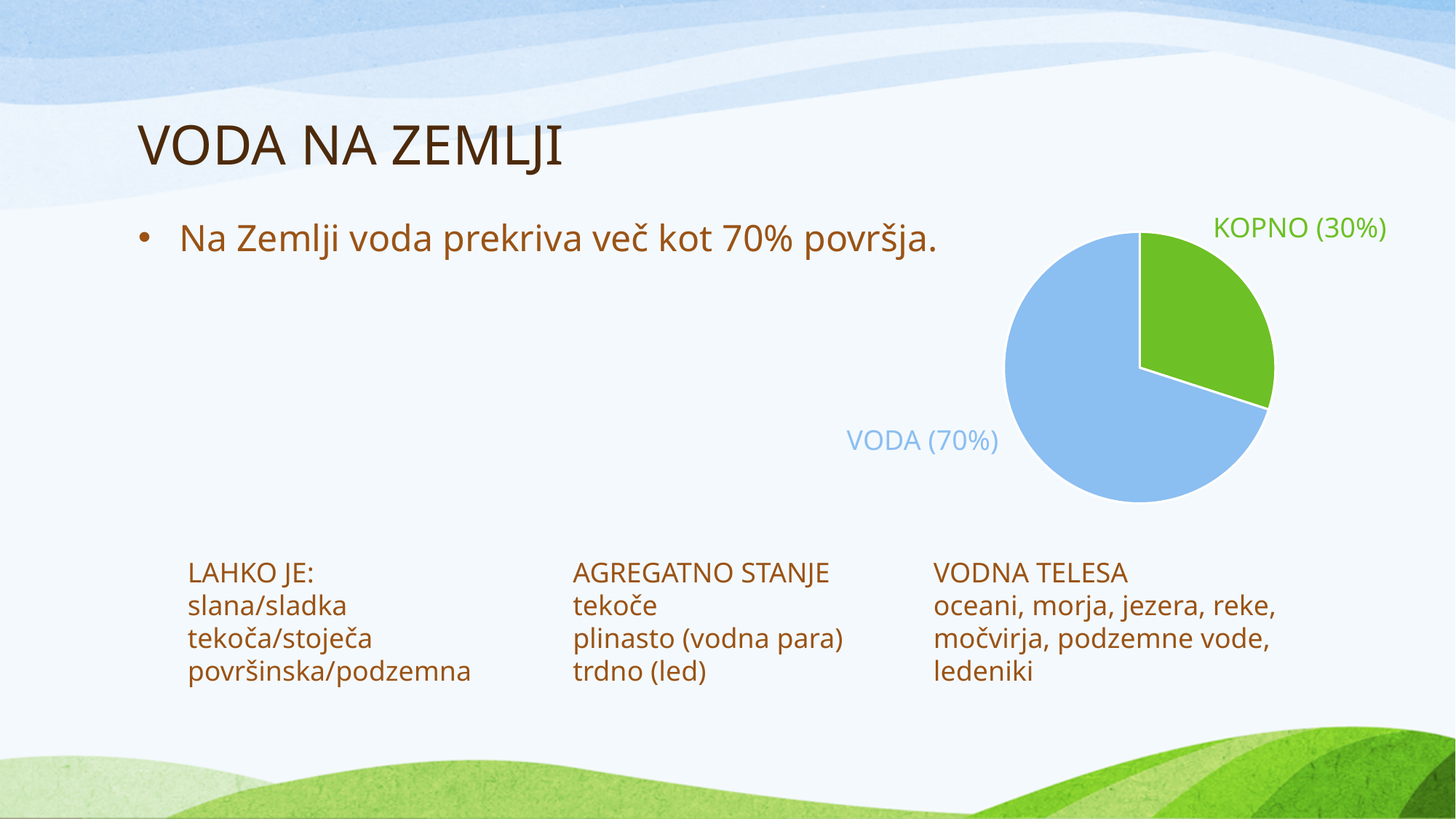
What colour is the VODA slice in the pie chart? blue Which slice of the pie chart is the largest? VODA What share of the pie does VODA represent? 70% Which slice of the pie chart is the smallest? KOPNO What colour is the KOPNO slice in the pie chart? green How many slices does the pie chart have? 2 What share of the pie does KOPNO represent? 30% What kind of chart is shown on the slide? pie chart What is the difference in percentage points between the VODA and KOPNO slices? 40% Which is larger, the VODA slice or the KOPNO slice? VODA